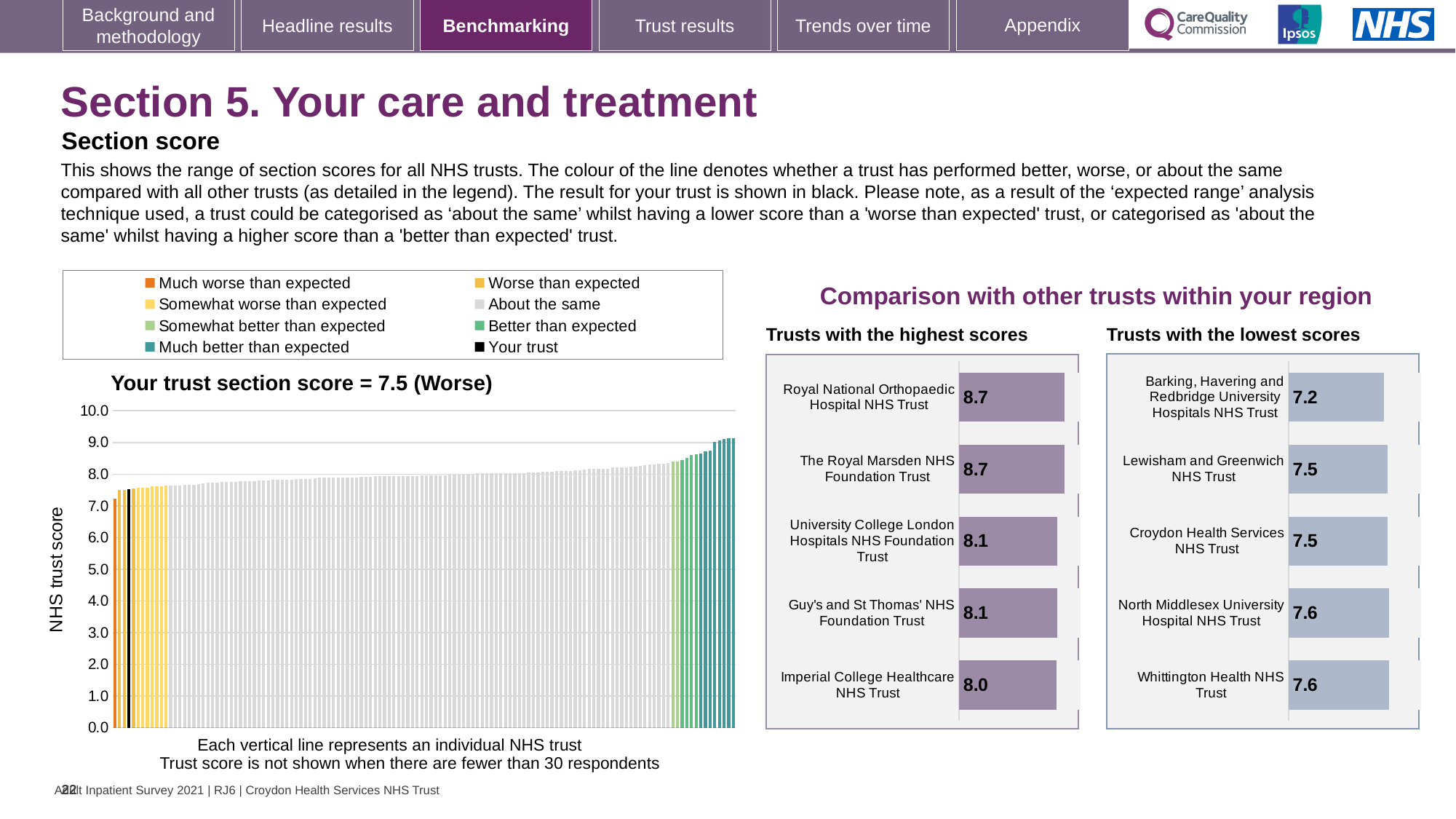
In the 'Trusts with the lowest scores' chart, which trust has the lowest score? Barking, Havering and Redbridge University Hospitals NHS Trust In the 'Trusts with the highest scores' chart, what is the score for Imperial College Healthcare NHS Trust? 8.0 In the chart on the left, do the bar values rise or fall from left to right? rise In the 'Trusts with the lowest scores' chart, what is the difference between the score for Whittington Health NHS Trust and the score for Barking, Havering and Redbridge University Hospitals NHS Trust? 0.4 In the 'Trusts with the highest scores' chart, what is the difference between the score for The Royal Marsden NHS Foundation Trust and the score for Imperial College Healthcare NHS Trust? 0.7 How many entries does the legend above the chart on the left list? 8 According to the title of the chart on the left, what is your trust's section score? 7.5 (Worse) In the 'Trusts with the lowest scores' chart, what is the score for Barking, Havering and Redbridge University Hospitals NHS Trust? 7.2 In the 'Trusts with the highest scores' chart, what is the score for Royal National Orthopaedic Hospital NHS Trust? 8.7 How many trusts are listed in the 'Trusts with the lowest scores' chart? 5 In the 'Trusts with the highest scores' chart, which has the larger score: University College London Hospitals NHS Foundation Trust or Imperial College Healthcare NHS Trust? University College London Hospitals NHS Foundation Trust In the chart on the left, is the value of the leftmost bar greater or less than 8.0? less